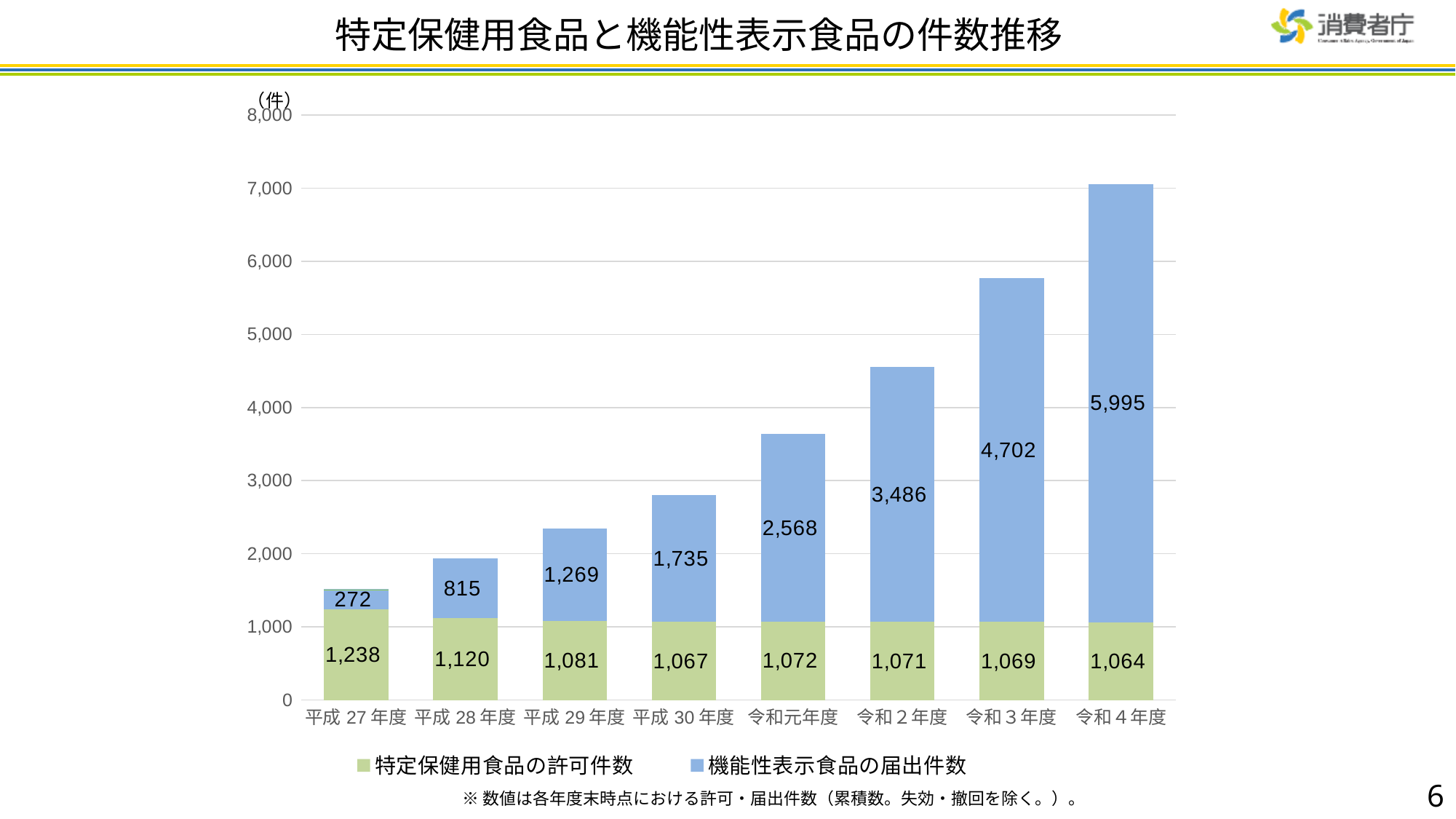
In which fiscal year is 特定保健用食品の許可件数 the highest? 平成27年度 Which is larger in 平成29年度: 特定保健用食品の許可件数 or 機能性表示食品の届出件数? 機能性表示食品の届出件数 What is the value of 機能性表示食品の届出件数 for 令和４年度? 5,995 What is the difference between 機能性表示食品の届出件数 in 令和４年度 and 令和３年度? 1,293 In which fiscal year is 機能性表示食品の届出件数 the lowest? 平成27年度 How many series does the legend list? 2 How many fiscal years (categories) are shown on the x axis? 8 What is the total height of the stacked bar for 令和４年度? 7,059 What type of chart is shown on the slide? Stacked bar chart Does 機能性表示食品の届出件数 rise or fall from 平成27年度 to 令和４年度? Rise What is the value of 機能性表示食品の届出件数 for 平成30年度? 1,735 What is the value of 特定保健用食品の許可件数 for 平成27年度? 1,238